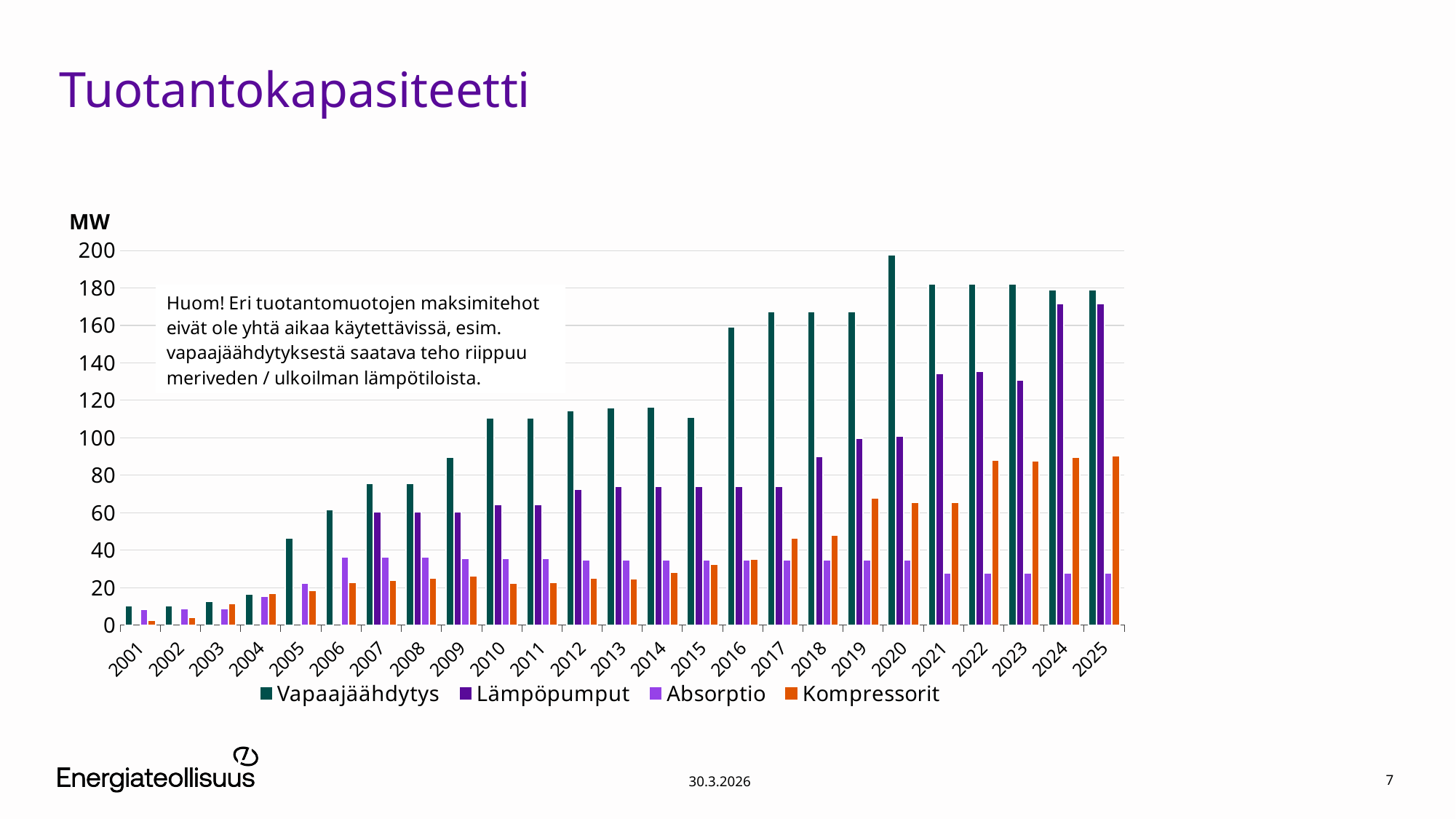
Is the Lämpöpumput value for 2024 greater or less than 160? greater In which year is the Vapaajäähdytys value highest? 2020 Is the Vapaajäähdytys value for 2020 greater or less than 180? greater What unit is shown on the y axis? MW In 2025, which is larger: Vapaajäähdytys or Lämpöpumput? Vapaajäähdytys What kind of chart is shown on the slide? bar chart How many series does the legend list? 4 In 2019, which is larger: Absorptio or Kompressorit? Kompressorit Is the Vapaajäähdytys value for 2005 greater or less than 40? greater Do the Kompressorit values generally rise or fall from 2001 to 2025? rise How many years are shown on the x axis? 25